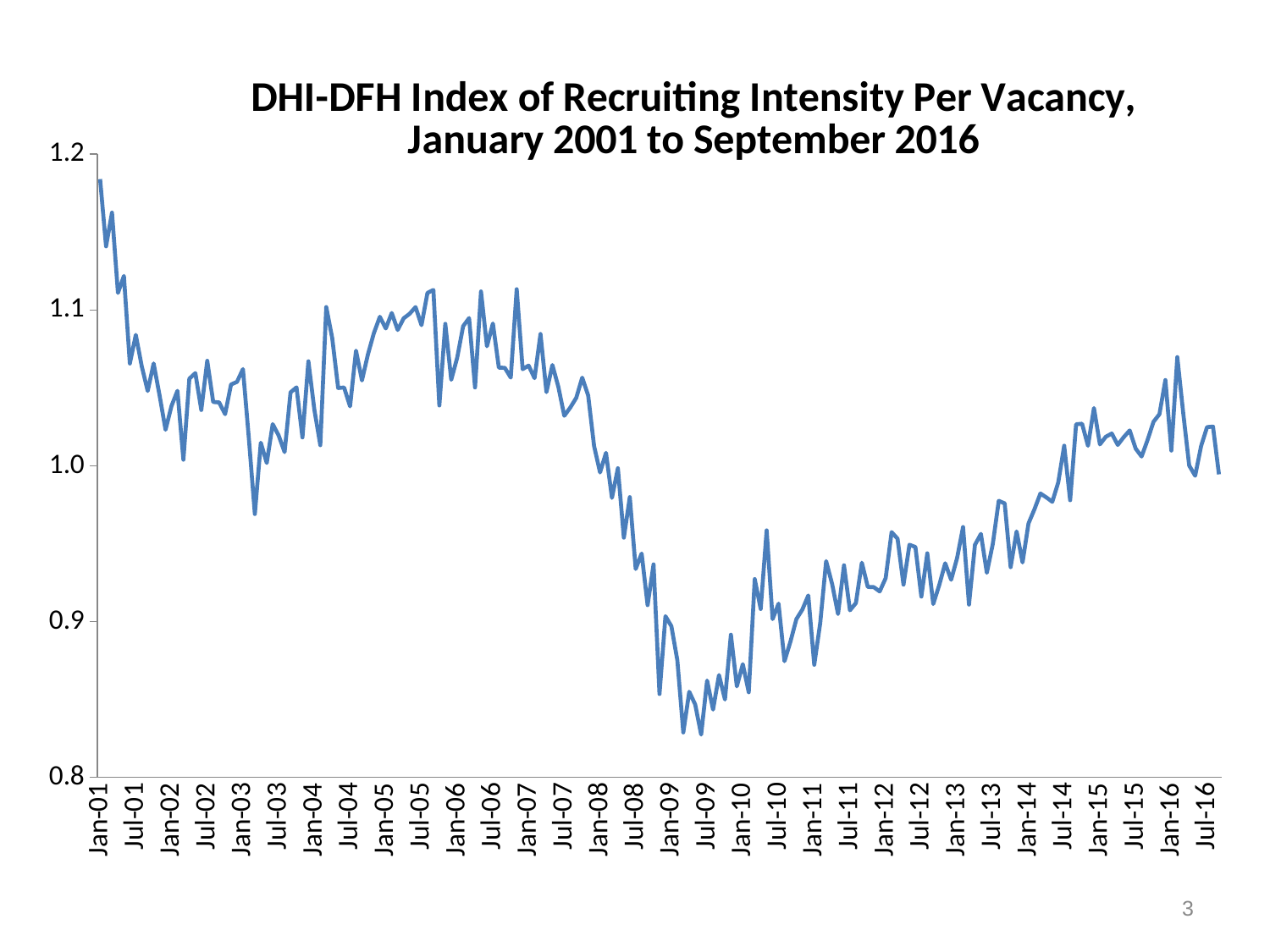
Is the value for Jan-01 greater or less than 1.1? greater Is the value for Jan-03 greater or less than 1.0? greater Does the index generally rise or fall between Jul-09 and Jan-16? rise Which is larger, the value for Jan-01 or the value for Jul-16? Jan-01 Is the value for Jul-09 greater or less than 0.9? less In which year does the index reach its lowest point? 2009 What is the lowest value shown on the vertical axis? 0.8 Does the index rise or fall between Jan-08 and Jul-09? fall What is the title of the chart? DHI-DFH Index of Recruiting Intensity Per Vacancy, January 2001 to September 2016 What kind of chart is shown on the slide? line chart